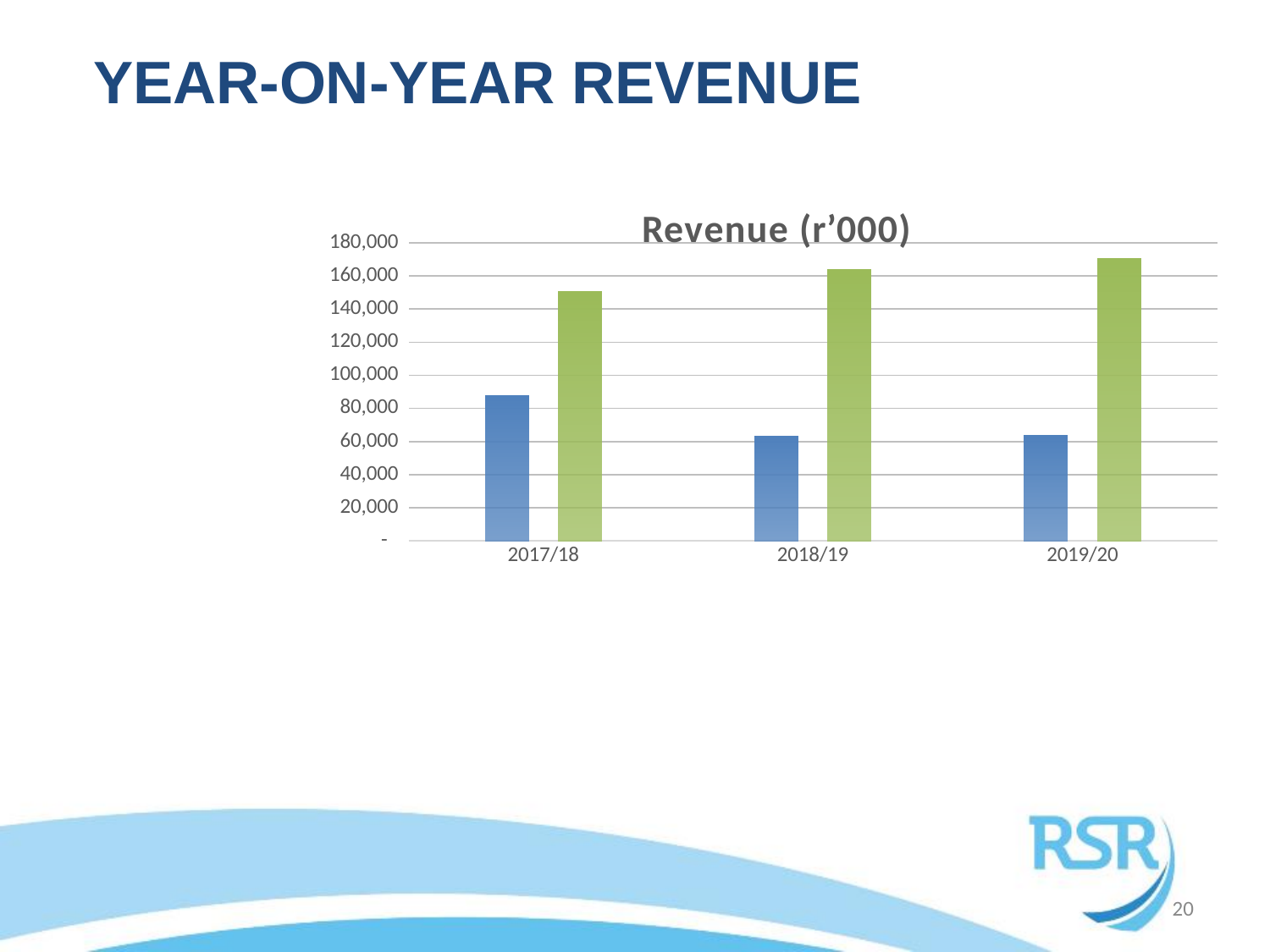
How many years are shown on the x axis of the chart? 3 In which year is the green bar the highest? 2019/20 Is the green bar for 2017/18 greater or less than 160,000? less What is the title of the chart? Revenue (r'000) What type of chart is shown on the slide? Bar chart How many bars are plotted for each year in the chart? 2 In which year is the green bar the lowest? 2017/18 In which year is the blue bar the highest? 2017/18 Do the green bars rise or fall from 2017/18 to 2019/20? Rise Is the blue bar for 2018/19 greater or less than 80,000? less For 2019/20, which bar is larger, the blue bar or the green bar? The green bar Is the blue bar for 2017/18 greater or less than 80,000? greater